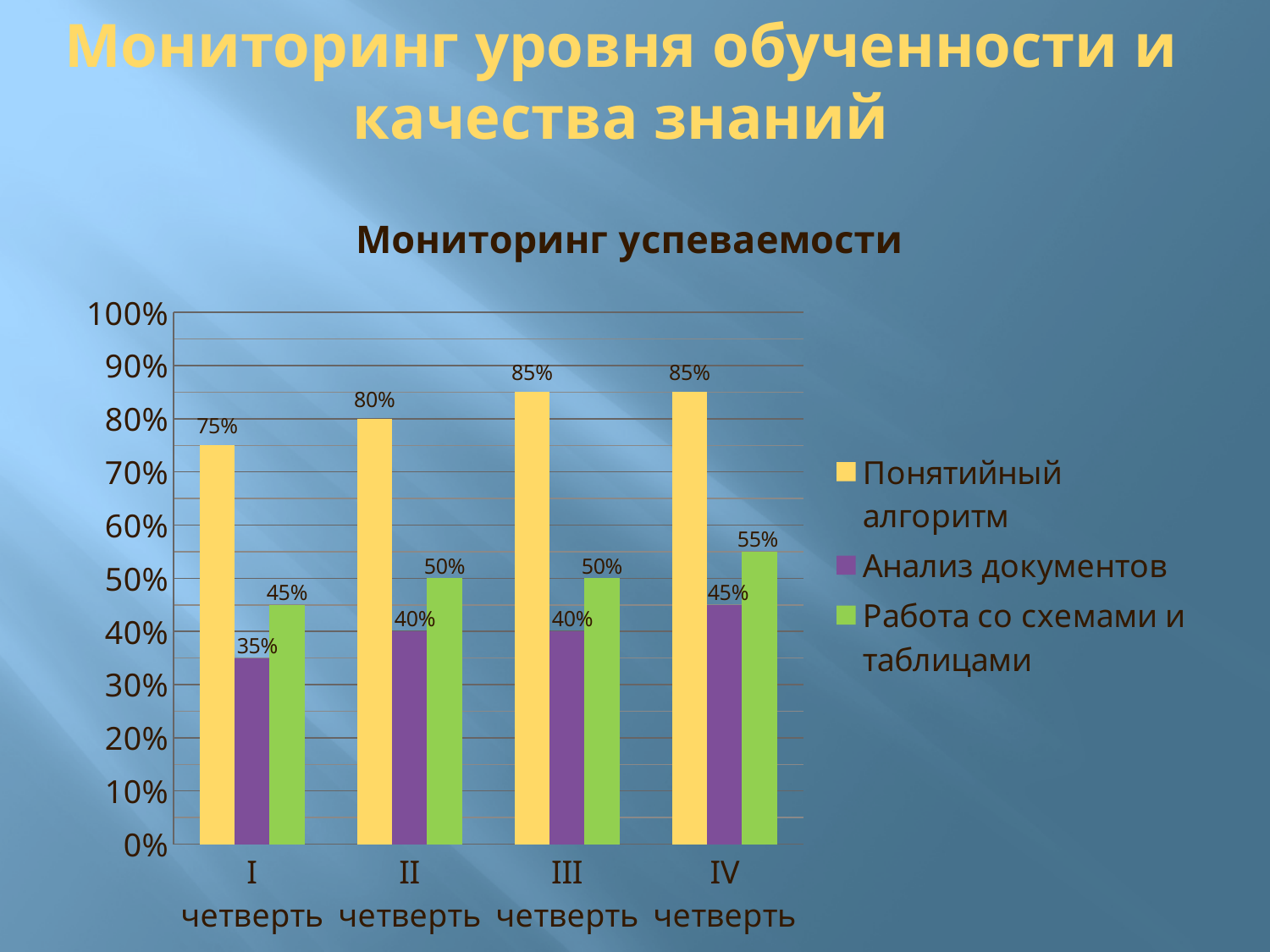
Which is larger in III четверть: Анализ документов or Работа со схемами и таблицами? Работа со схемами и таблицами What is the value for Анализ документов in IV четверть? 45% What is the value for Работа со схемами и таблицами in II четверть? 50% What is the title of the chart? Мониторинг успеваемости In which quarter is the value for Анализ документов lowest? I четверть What is the value for Понятийный алгоритм in I четверть? 75% How many series does the legend list? 3 In which quarter is the value for Работа со схемами и таблицами highest? IV четверть How many quarters are shown on the x axis? 4 What kind of chart is shown? Bar chart What is the difference between Понятийный алгоритм and Анализ документов in II четверть? 40% Does the value for Понятийный алгоритм rise or fall from I четверть to III четверть? Rise